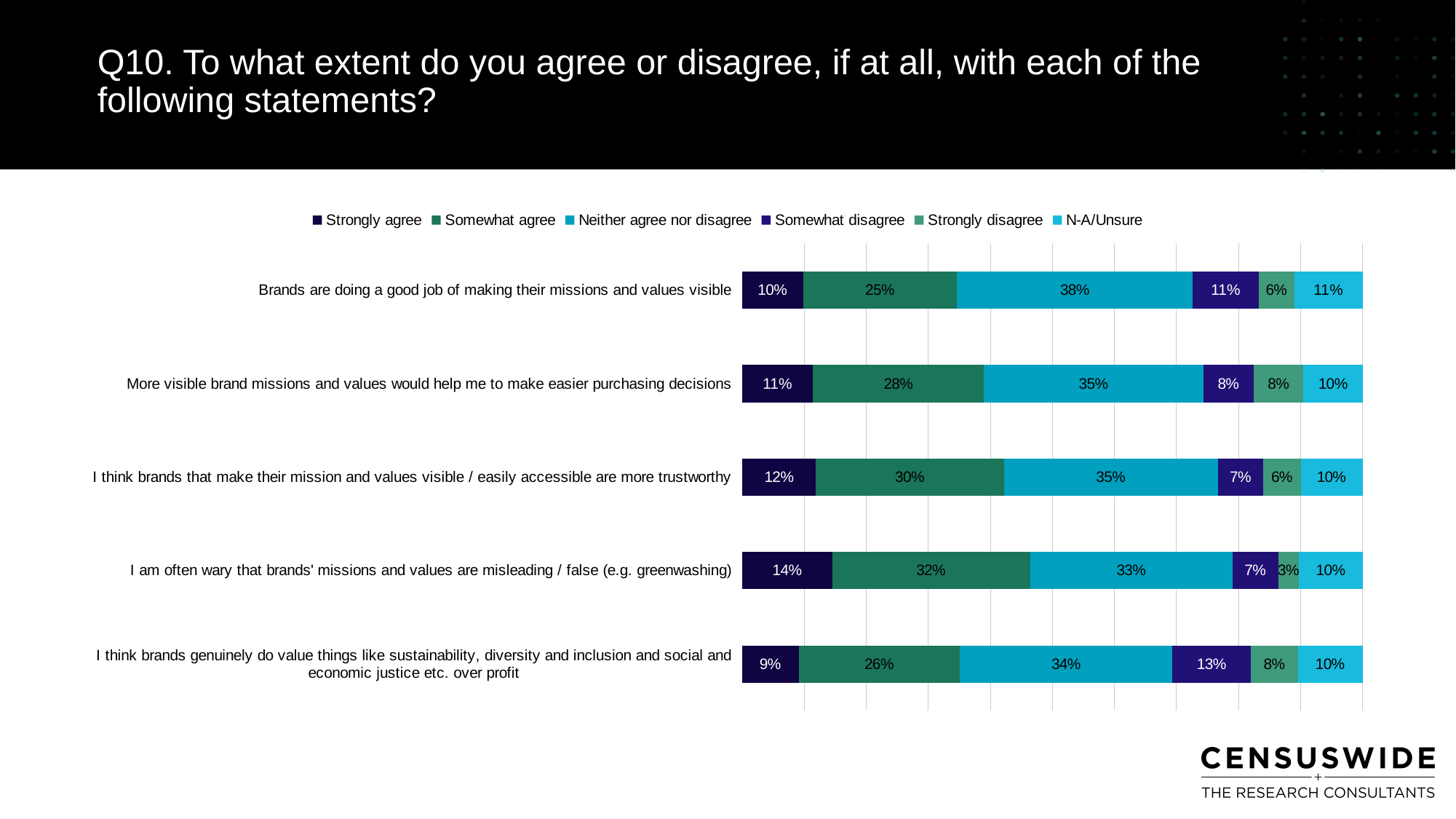
What percentage strongly disagree with the statement 'I am often wary that brands' missions and values are misleading / false (e.g. greenwashing)'? 3% What type of chart is shown on the slide? Stacked bar chart What percentage somewhat agree that brands that make their mission and values visible / easily accessible are more trustworthy? 30% What percentage strongly agree that brands are doing a good job of making their missions and values visible? 10% How many statements are shown in the chart? 5 Which has a larger 'Somewhat disagree' percentage: 'I think brands genuinely do value things like sustainability... over profit' or 'I think brands that make their mission and values visible / easily accessible are more trustworthy'? I think brands genuinely do value things like sustainability, diversity and inclusion and social and economic justice etc. over profit Which statement has the highest 'Strongly agree' percentage? I am often wary that brands' missions and values are misleading / false (e.g. greenwashing) What is the combined percentage of 'Strongly agree' and 'Somewhat agree' for the statement 'I am often wary that brands' missions and values are misleading / false (e.g. greenwashing)'? 46% What is the difference between the 'Somewhat agree' percentages for 'I am often wary that brands' missions and values are misleading / false' and 'Brands are doing a good job of making their missions and values visible'? 7% Which statement has the lowest 'Strongly agree' percentage? I think brands genuinely do value things like sustainability, diversity and inclusion and social and economic justice etc. over profit What percentage neither agree nor disagree with the statement 'More visible brand missions and values would help me to make easier purchasing decisions'? 35% How many response categories does the legend list? 6